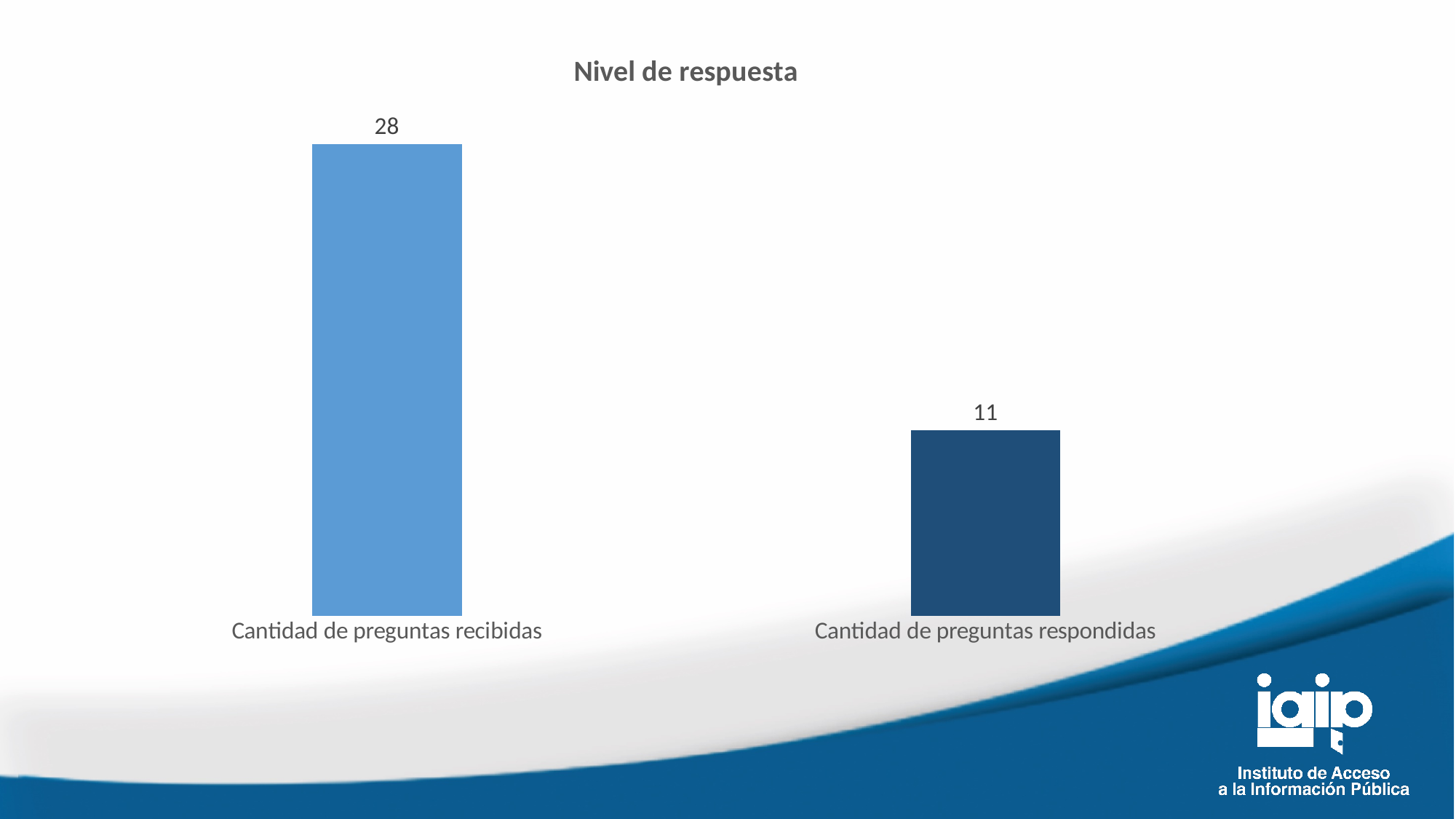
How many categories are shown in the chart? 2 What is the value for "Cantidad de preguntas respondidas"? 11 What kind of chart is shown on the slide? Bar chart What colour is the bar for "Cantidad de preguntas respondidas"? Dark blue Which is larger: the value for "Cantidad de preguntas recibidas" or "Cantidad de preguntas respondidas"? Cantidad de preguntas recibidas What is the difference between the values for "Cantidad de preguntas recibidas" and "Cantidad de preguntas respondidas"? 17 What is the value for "Cantidad de preguntas recibidas"? 28 What is the total of the two values shown in the chart? 39 Which category has the highest value? Cantidad de preguntas recibidas What is the title of the chart? Nivel de respuesta Which category has the lowest value? Cantidad de preguntas respondidas